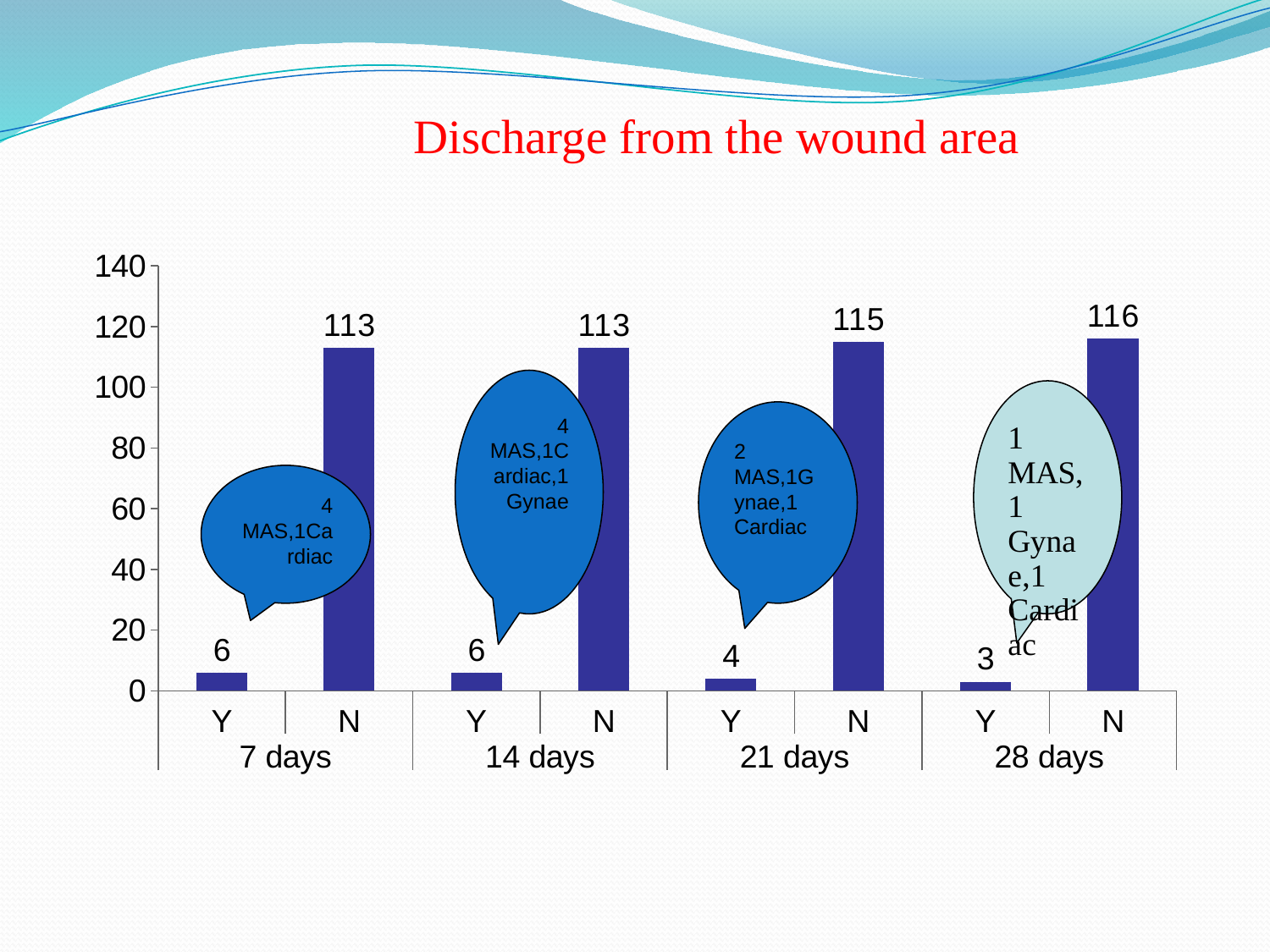
What is the difference between the N values at 28 days and 7 days? 3 How many bars are plotted on the chart? 8 Which is larger, the Y value at 7 days or the Y value at 21 days? Y at 7 days What is the title of the chart? Discharge from the wound area What kind of chart is shown on the slide? bar chart What is the difference between the N and Y values at 21 days? 111 Which bar has the lowest value on the chart? Y at 28 days Which bar has the highest value on the chart? N at 28 days What is the value for N at 21 days? 115 What is the value for Y at 14 days? 6 What is the value for Y at 28 days? 3 What is the value for N at 7 days? 113